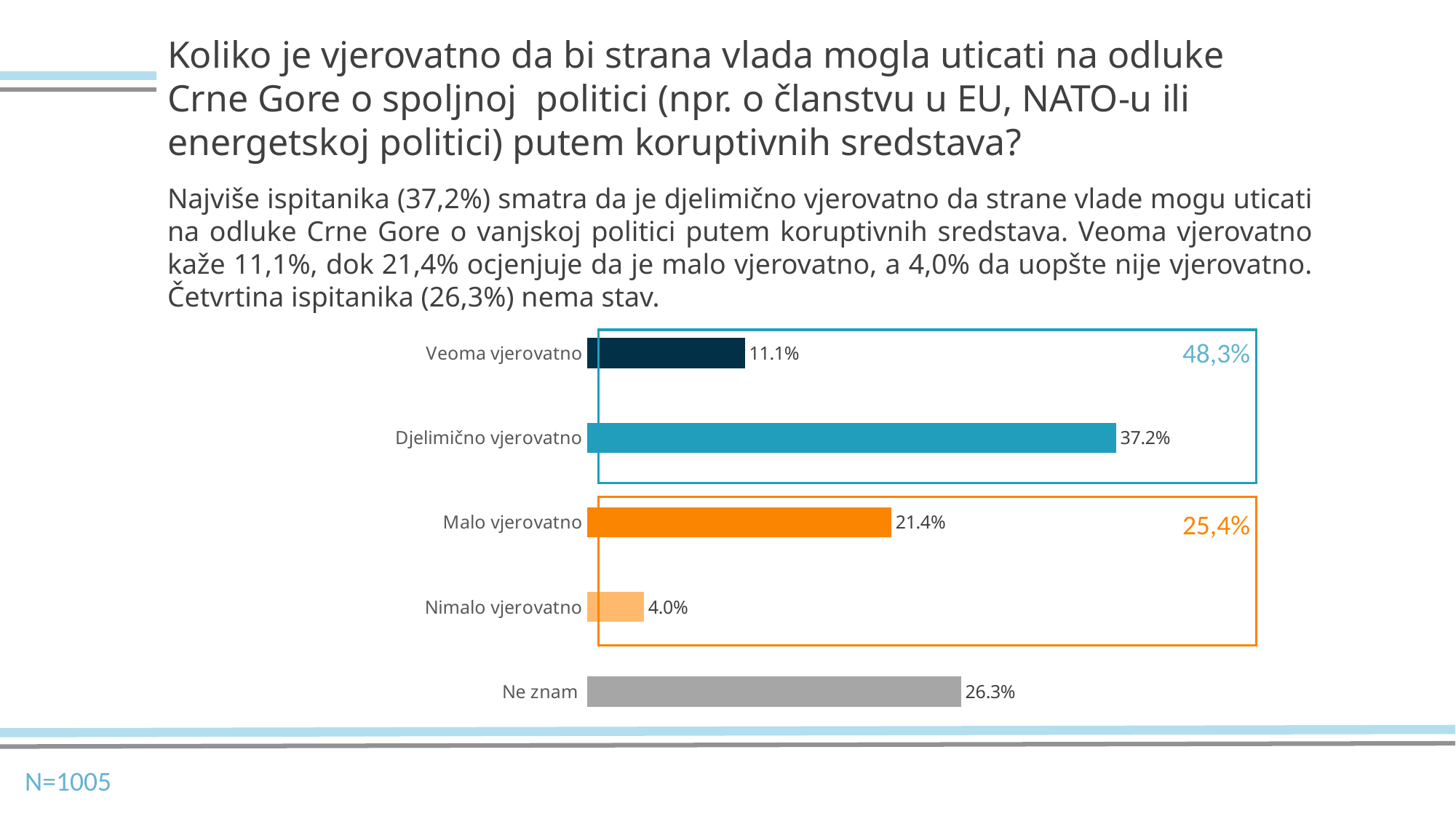
Which category has the highest value? Djelimično vjerovatno What is the difference between "Djelimično vjerovatno" and "Malo vjerovatno"? 15.8% What combined percentage is shown in the blue box grouping "Veoma vjerovatno" and "Djelimično vjerovatno"? 48,3% What is the value for "Nimalo vjerovatno"? 4.0% Which is larger, "Ne znam" or "Malo vjerovatno"? Ne znam What kind of chart is shown on the slide? Bar chart How many categories are shown in the chart? 5 What combined percentage is shown in the orange box grouping "Malo vjerovatno" and "Nimalo vjerovatno"? 25,4% What is the value for "Djelimično vjerovatno"? 37.2% What is the value for "Veoma vjerovatno"? 11.1% Which category has the lowest value? Nimalo vjerovatno What is the value for "Ne znam"? 26.3%